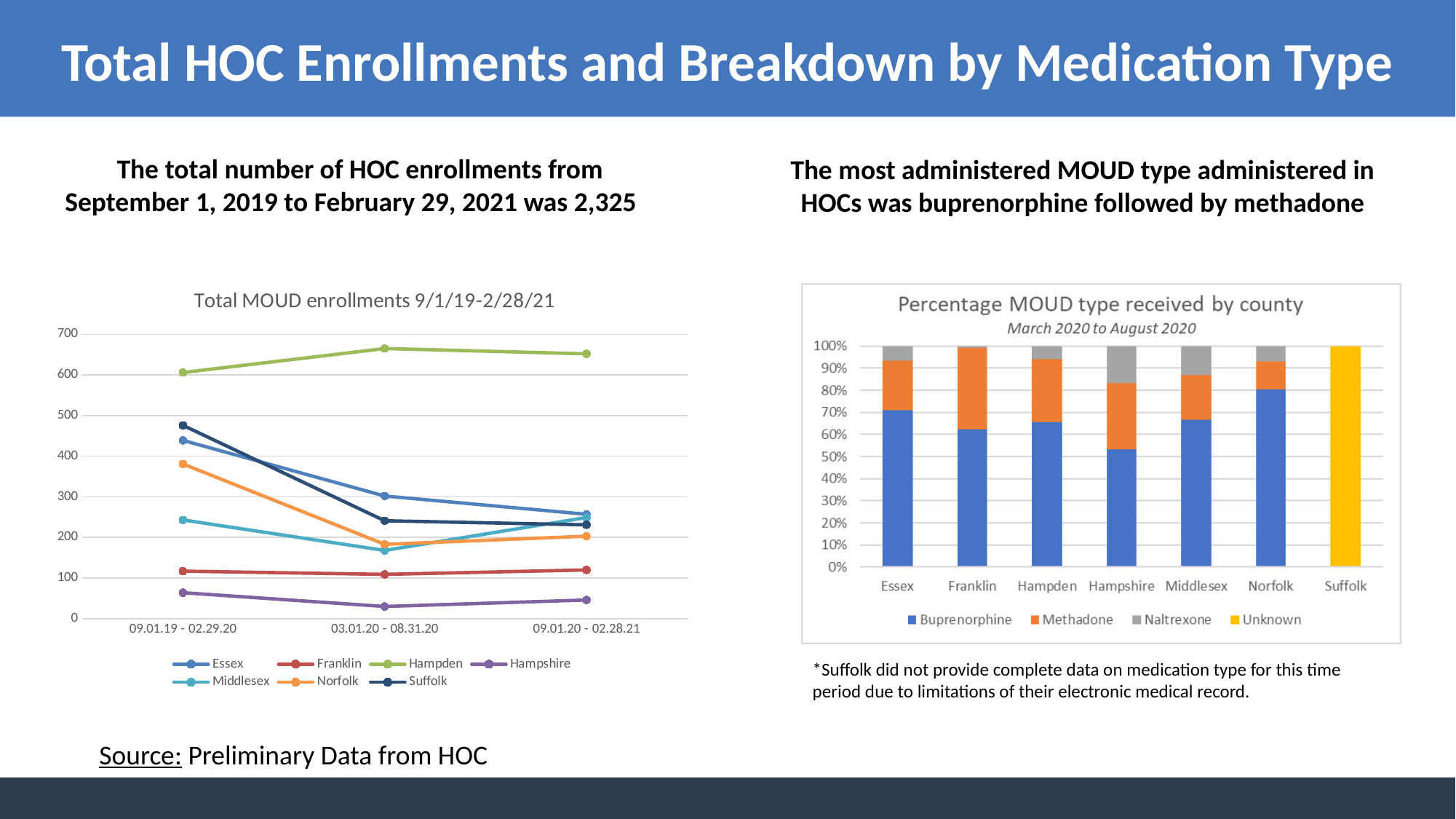
How many series does the legend of the 'Total MOUD enrollments 9/1/19-2/28/21' chart list? 7 In the 'Percentage MOUD type received by county' chart, which county is shown entirely as Unknown? Suffolk How many counties are shown on the x axis of the 'Percentage MOUD type received by county' chart? 7 What kind of chart is the 'Percentage MOUD type received by county' chart? stacked bar chart What kind of chart is the 'Total MOUD enrollments 9/1/19-2/28/21' chart? line chart In the 'Total MOUD enrollments 9/1/19-2/28/21' chart, which county has the highest enrollments across all three periods? Hampden In the 'Total MOUD enrollments 9/1/19-2/28/21' chart, which county has the lowest enrollments across all three periods? Hampshire In the 'Total MOUD enrollments 9/1/19-2/28/21' chart, do Essex enrollments rise or fall from the first period to the last? fall In the 'Percentage MOUD type received by county' chart, which county has the largest buprenorphine share? Norfolk In the 'Total MOUD enrollments 9/1/19-2/28/21' chart, is the value for Suffolk in 09.01.19 - 02.29.20 greater or less than 500? less In the 'Total MOUD enrollments 9/1/19-2/28/21' chart, is the value for Hampden in 03.01.20 - 08.31.20 greater or less than 600? greater How many time periods are shown on the x axis of the 'Total MOUD enrollments 9/1/19-2/28/21' chart? 3